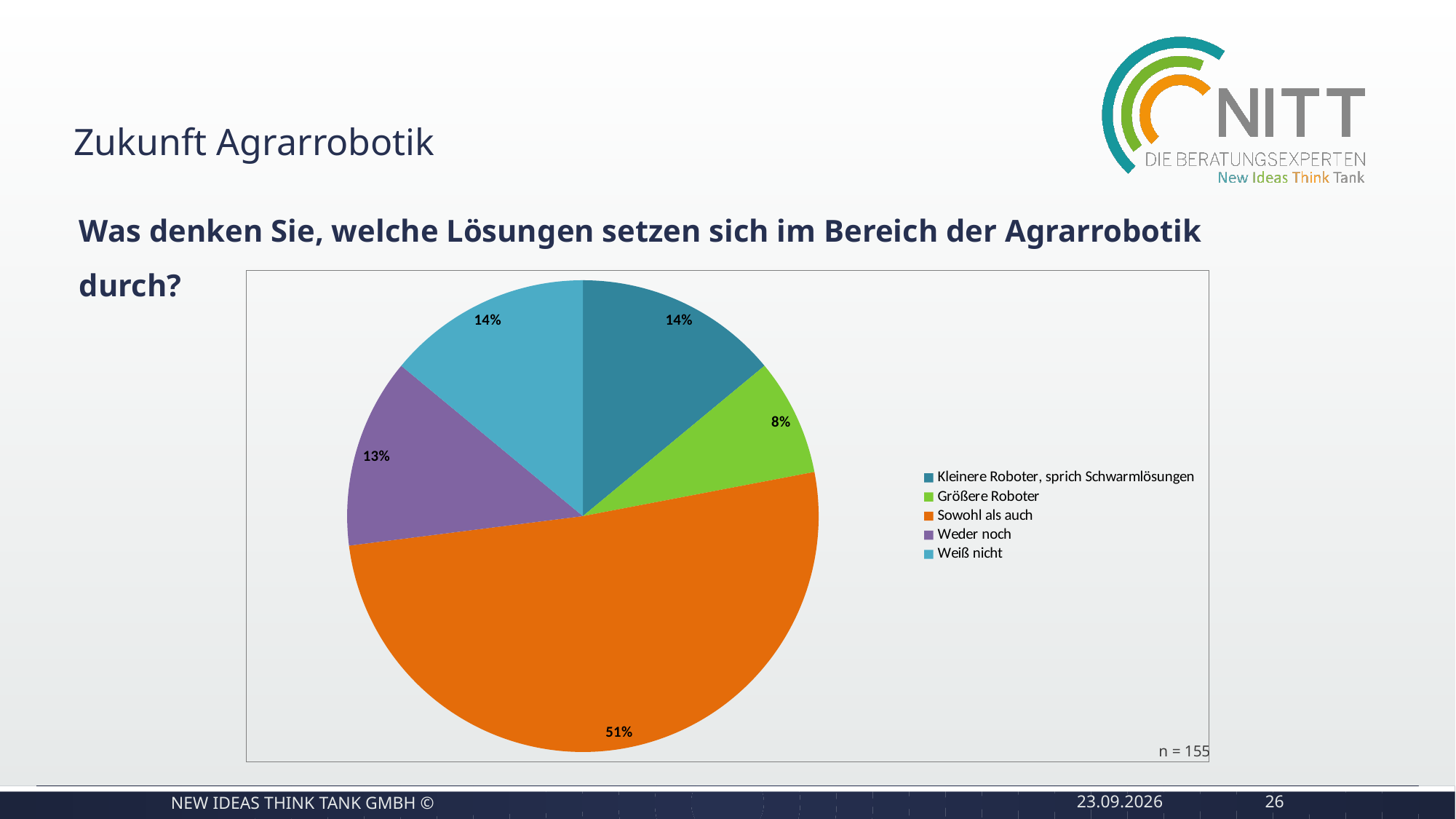
What share of the pie does "Kleinere Roboter, sprich Schwarmlösungen" have? 14% Which category has the largest slice of the pie? Sowohl als auch What type of chart is shown on the slide? Pie chart What share of the pie does "Sowohl als auch" have? 51% What sample size (n) is stated on the chart? n = 155 What is the difference in percentage points between "Sowohl als auch" and "Weder noch"? 38 percentage points Which category has the smallest slice of the pie? Größere Roboter How many categories does the pie chart show? 5 What share of the pie does "Weder noch" have? 13% Which colour represents "Sowohl als auch" in the pie chart? Orange Which is larger, the slice for "Weder noch" or the slice for "Größere Roboter"? Weder noch